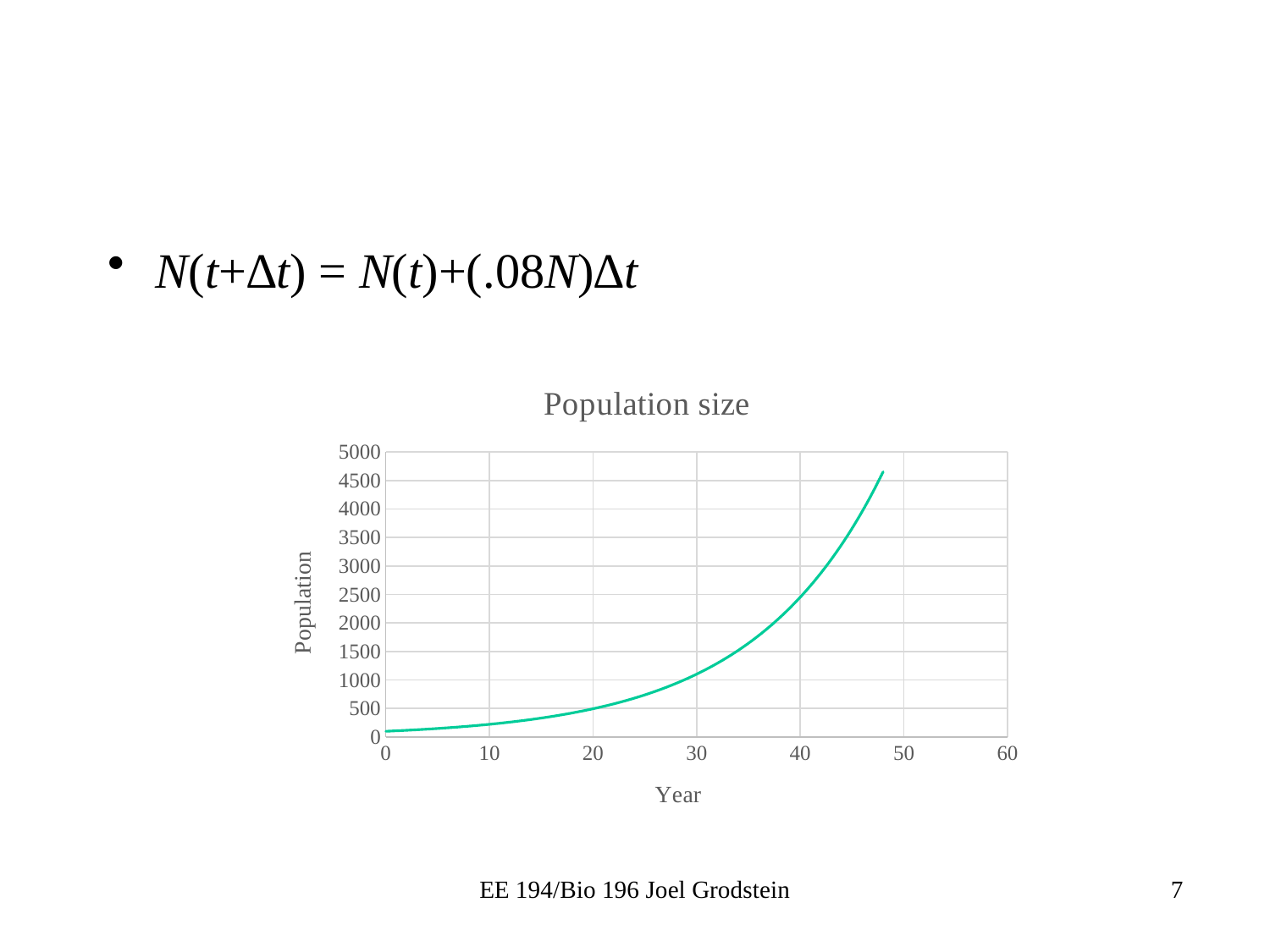
Is the population at year 0 greater or less than 500? less Is the highest population value on the curve greater or less than 5000? less Is the population at year 40 greater or less than 3000? less What is the title of the chart? Population size Does the population rise or fall as the year increases? rise What kind of chart is shown on the slide? line chart What is the label of the x axis? Year Is the population at year 20 larger or smaller than the population at year 40? smaller